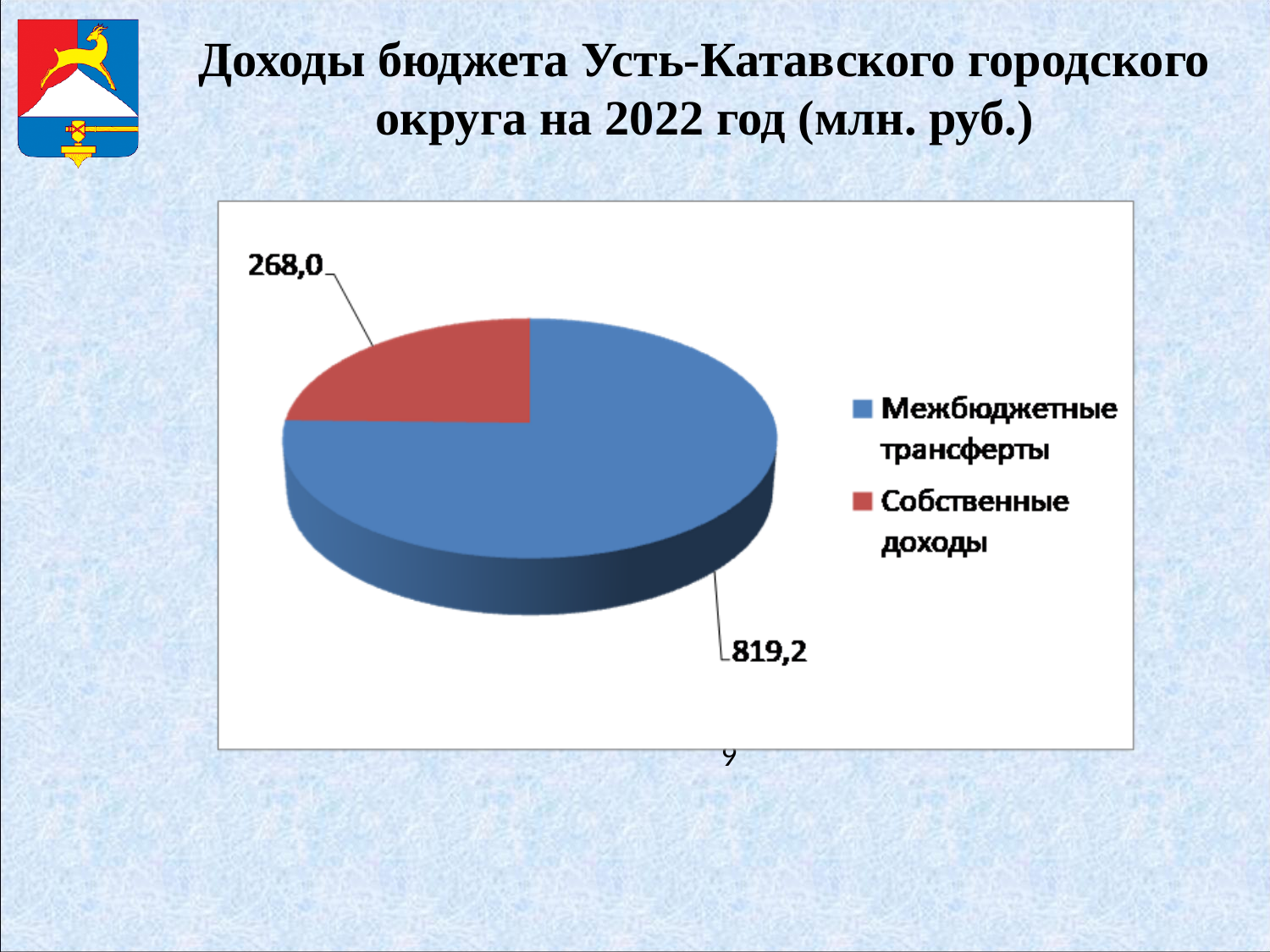
What is the title of the slide containing the chart? Доходы бюджета Усть-Катавского городского округа на 2022 год (млн. руб.) How many entries does the legend list? 2 What is the total of the two slices in the pie chart? 1087,2 What is the difference between Межбюджетные трансферты and Собственные доходы? 551,2 How many slices does the pie chart have? 2 Which is larger, Межбюджетные трансферты or Собственные доходы? Межбюджетные трансферты Which category has the smallest slice of the pie? Собственные доходы What is the value for Собственные доходы? 268,0 What kind of chart is shown on the slide? Pie chart What colour is the slice for Собственные доходы? Red Which category has the largest slice of the pie? Межбюджетные трансферты What is the value for Межбюджетные трансферты? 819,2